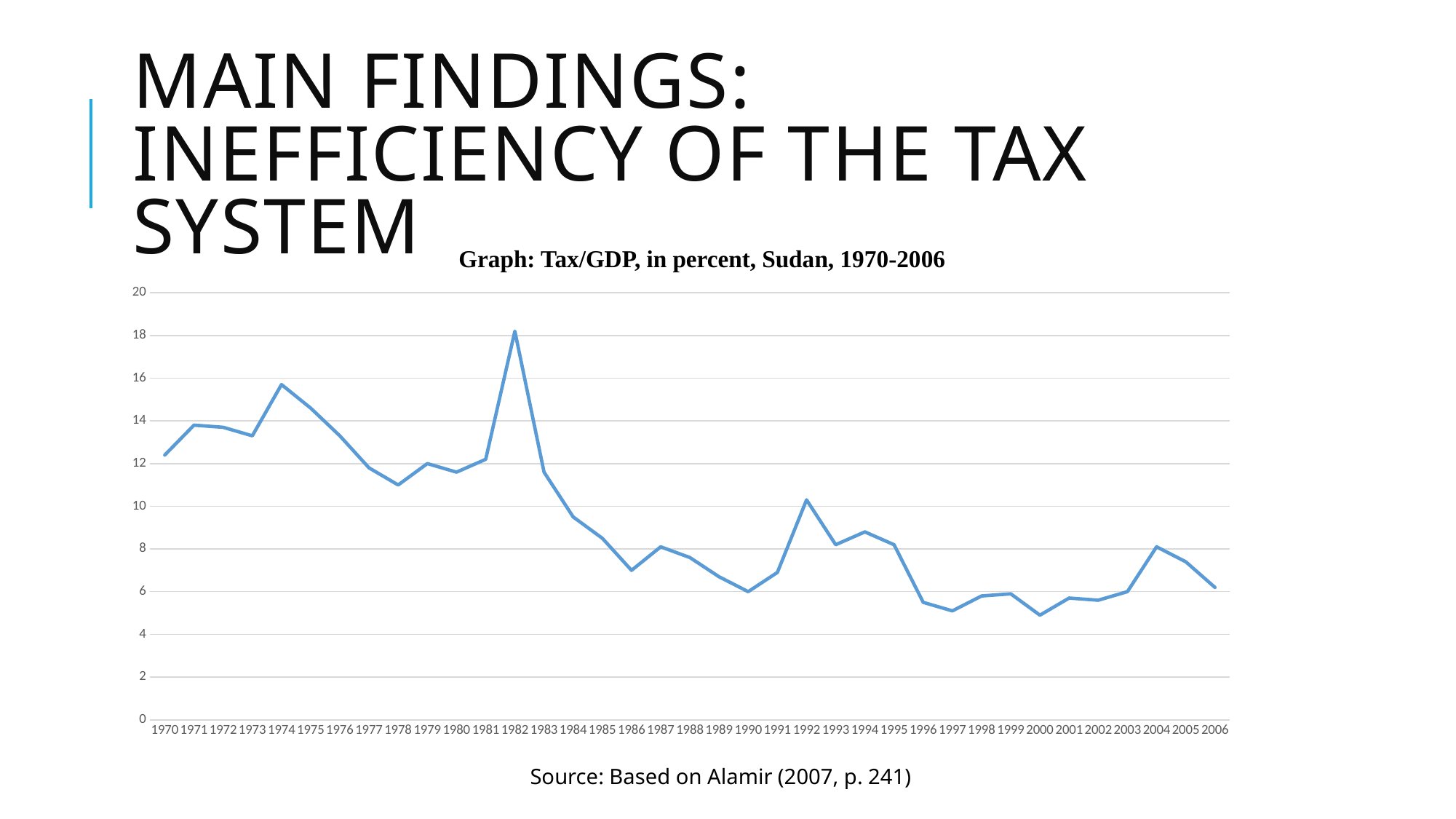
How many years are plotted along the x axis? 37 Which year has the higher Tax/GDP value, 1984 or 1996? 1984 In which year does the Tax/GDP line reach its highest value? 1982 What kind of chart is shown on the slide? Line chart Is the value for 2006 greater or less than 8? less Is the value for 1982 greater or less than 16? greater Is the value for 1990 greater or less than 8? less Overall, does the Tax/GDP ratio rise or fall from 1970 to 2006? Fall What is the title of the chart? Graph: Tax/GDP, in percent, Sudan, 1970-2006 Which year has the higher Tax/GDP value, 1974 or 1992? 1974